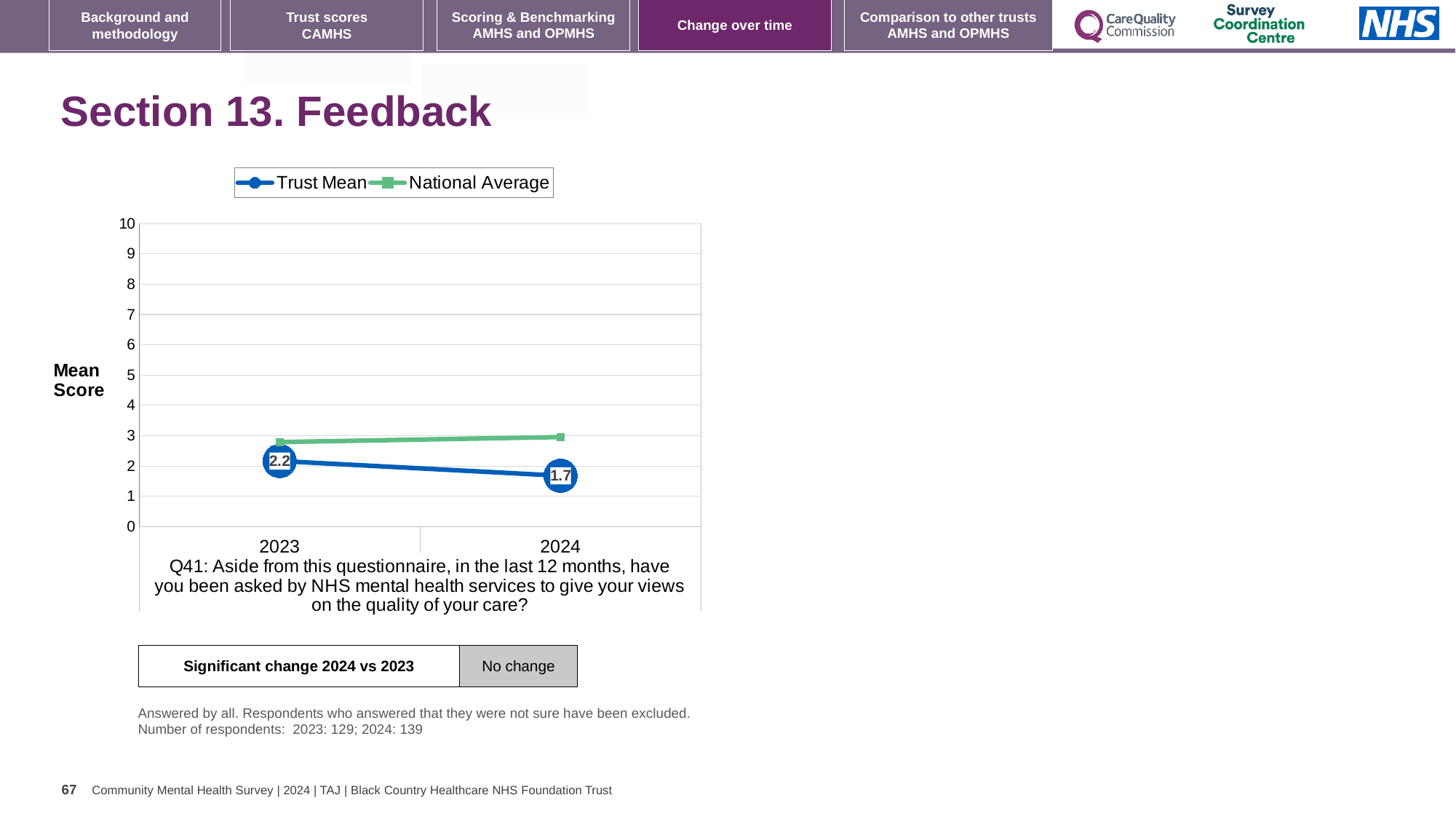
By how much did the Trust Mean change between 2023 and 2024? 0.5 Does the Trust Mean rise or fall from 2023 to 2024? fall What is the Trust Mean value for 2023? 2.2 What is the label on the y axis of the chart? Mean Score What kind of chart is shown on the slide? line chart How many years are plotted on the x axis? 2 Is the National Average value for 2024 greater or less than 2? greater Which year has the higher Trust Mean, 2023 or 2024? 2023 What is the Trust Mean value for 2024? 1.7 In 2024, which is higher, the Trust Mean or the National Average? National Average In which year is the Trust Mean lowest? 2024 How many series does the legend list? 2